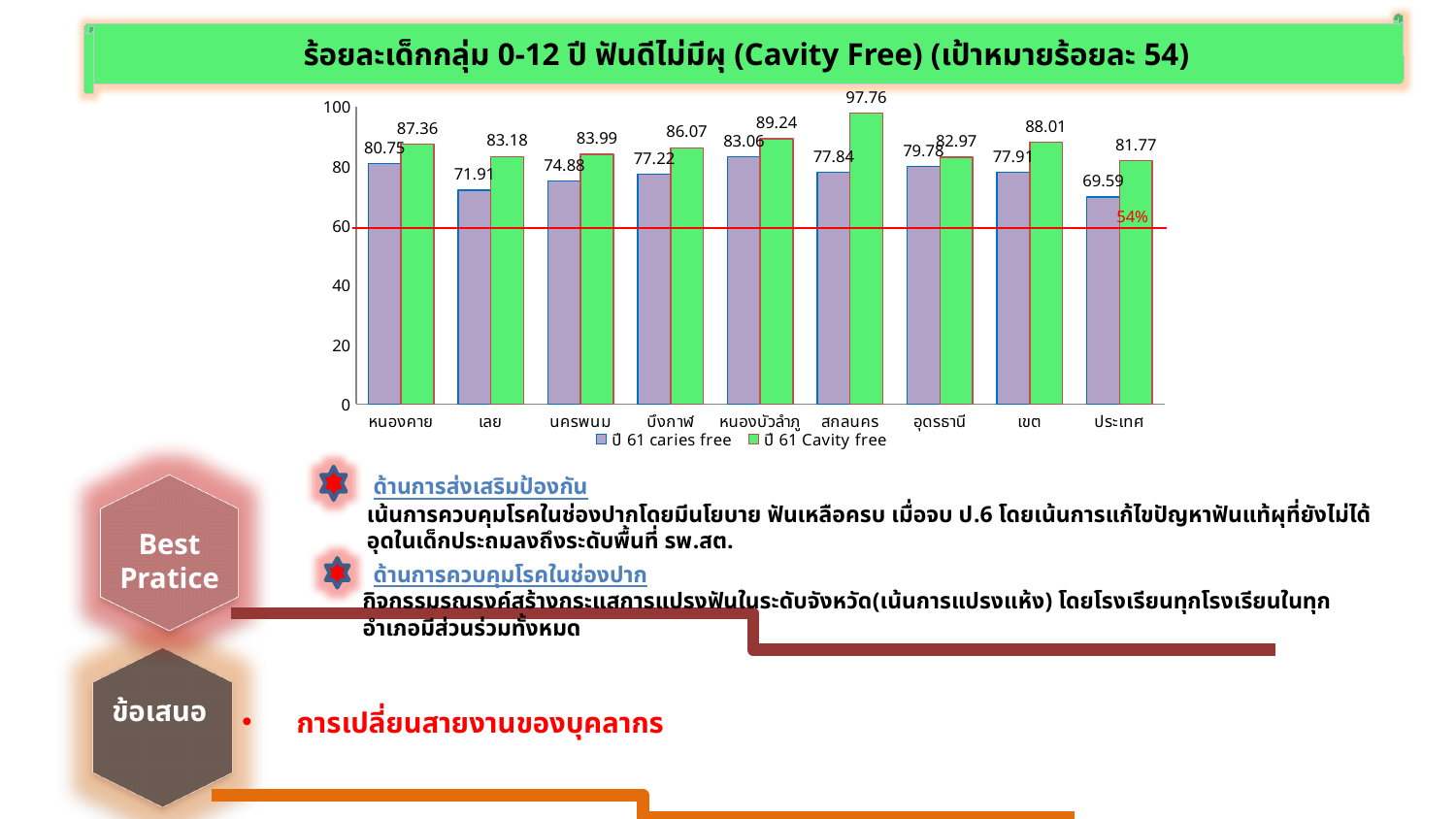
What is the value of ปี 61 caries free for หนองบัวลำภู? 83.06 What type of chart is shown on the slide? bar chart What target percentage is labelled on the red horizontal line in the chart? 54% How many categories are shown on the x axis of the chart? 9 How many series does the chart legend list? 2 Which is larger for เลย: the ปี 61 caries free value or the ปี 61 Cavity free value? ปี 61 Cavity free Which category has the highest ปี 61 Cavity free value? สกลนคร Is the ปี 61 caries free value for อุดรธานี greater or less than 60? greater What is the value of ปี 61 Cavity free for สกลนคร? 97.76 What is the value of ปี 61 caries free for ประเทศ? 69.59 Which category has the lowest ปี 61 caries free value? ประเทศ What is the difference between the ปี 61 Cavity free and ปี 61 caries free values for สกลนคร? 19.92